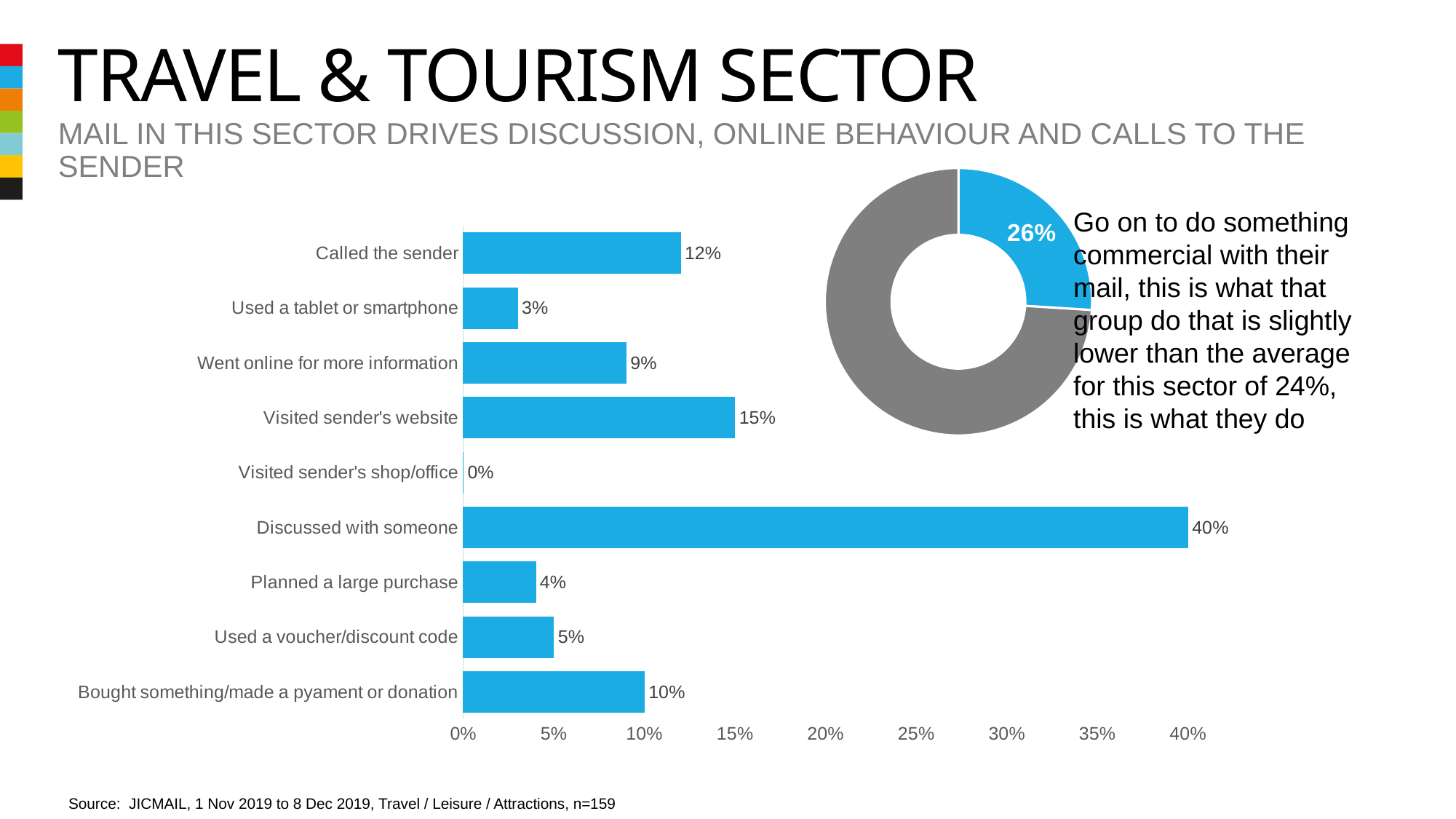
In the bar chart, which category has the lowest value? Visited sender's shop/office What kind of chart is the chart on the right of the slide? Doughnut chart What kind of chart is the chart on the left of the slide? Bar chart In the bar chart, which is larger: 'Used a voucher/discount code' or 'Planned a large purchase'? Used a voucher/discount code In the bar chart, what is the value for 'Called the sender'? 12% In the doughnut chart, what share is shown for the blue slice? 26% In the bar chart, which category has the highest value? Discussed with someone In the bar chart, what is the difference between 'Visited sender's website' and 'Went online for more information'? 6% In the bar chart, what is the value for 'Bought something/made a pyament or donation'? 10% In the bar chart, what is the value for 'Discussed with someone'? 40% In the bar chart, what is the value for 'Used a tablet or smartphone'? 3% How many categories does the bar chart show? 9